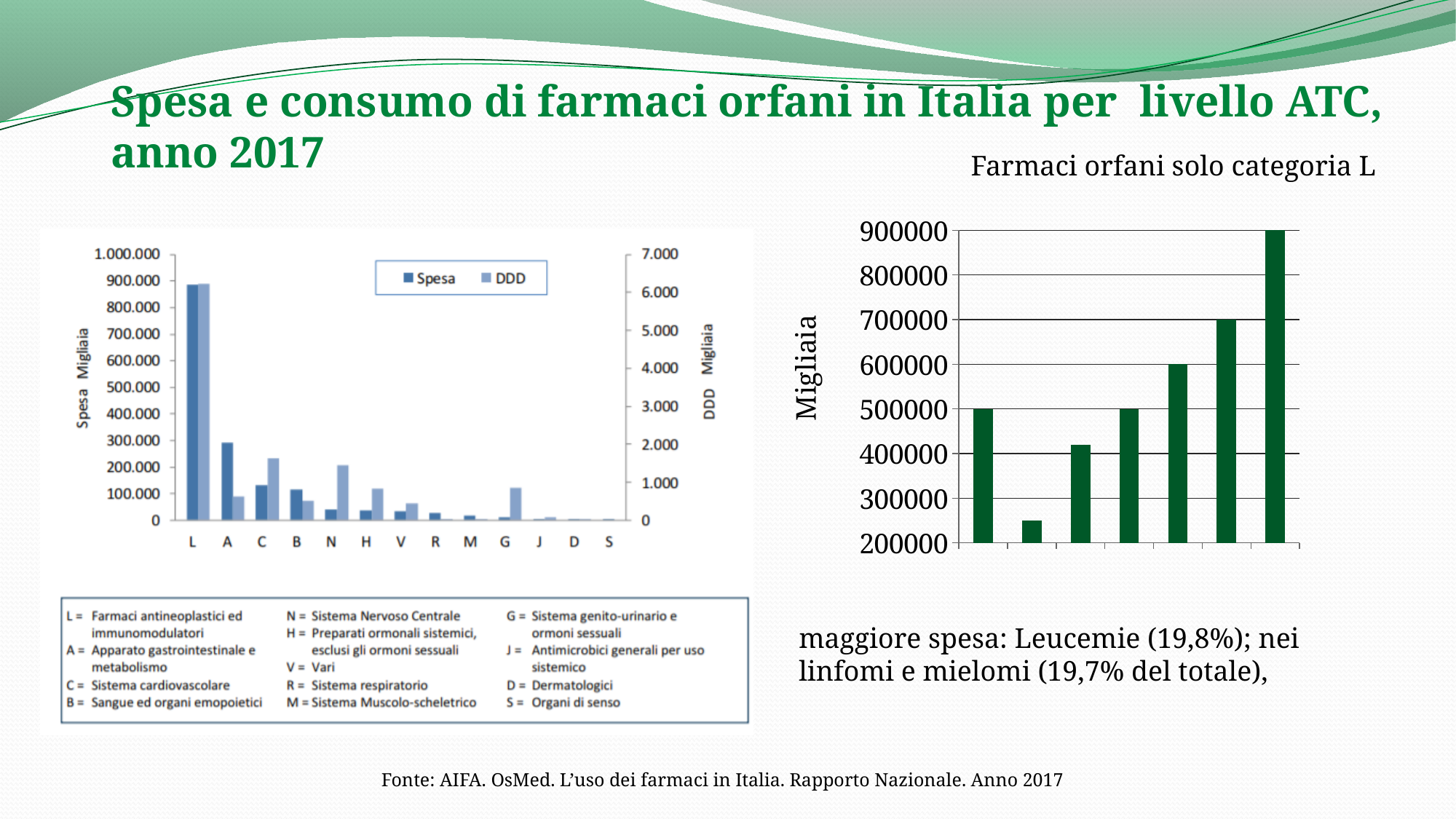
In the right chart titled 'Farmaci orfani solo categoria L', how many bars are plotted? 7 What kind of chart is the left chart showing Spesa and DDD by ATC level? bar chart In the left chart (Spesa and DDD by ATC level), is the Spesa value for L greater or less than 800.000? greater In the left chart (Spesa and DDD by ATC level), which is larger: the Spesa value for A or the Spesa value for C? A In the right chart titled 'Farmaci orfani solo categoria L', what is the label of the vertical axis? Migliaia In the left chart (Spesa and DDD by ATC level), which is larger: the DDD value for N or the DDD value for H? N In the right chart titled 'Farmaci orfani solo categoria L', is the value of the second bar greater or less than 300000? less In the left chart (Spesa and DDD by ATC level), is the DDD value for C greater or less than 1.000? greater In the left chart (Spesa and DDD by ATC level), which category has the highest Spesa? L In the left chart (Spesa and DDD by ATC level), what does the letter N stand for according to the key below the chart? Sistema Nervoso Centrale In the left chart (Spesa and DDD by ATC level), how many ATC categories are shown on the x axis? 13 In the left chart (Spesa and DDD by ATC level), how many series does the legend list? 2